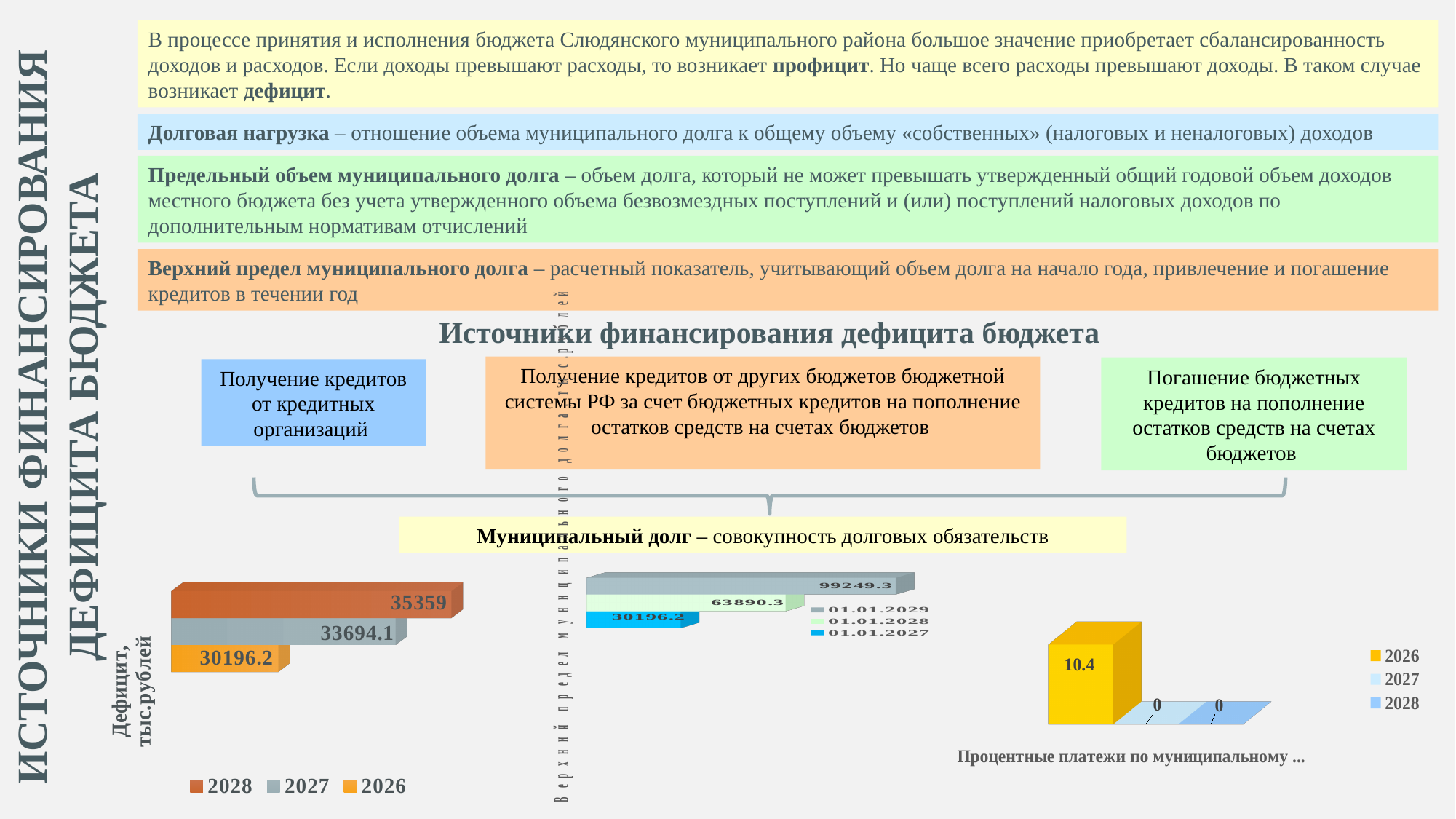
In the middle chart, what is the value for 01.01.2028? 63890.3 In the middle chart, what is the value for 01.01.2029? 99249.3 In the left chart (Дефицит, тыс.рублей), what is the value for 2028? 35359 What type of chart is the right chart (Процентные платежи по муниципальному ...)? Bar chart In the left chart (Дефицит, тыс.рублей), which year has the highest value? 2028 In the right chart (Процентные платежи по муниципальному ...), what is the value for 2026? 10.4 In the middle chart, which date has the lowest value? 01.01.2027 In the left chart (Дефицит, тыс.рублей), what is the value for 2026? 30196.2 In the left chart (Дефицит, тыс.рублей), what is the difference between the 2028 and 2027 values? 1664.9 In the middle chart, what is the difference between the 01.01.2029 and 01.01.2027 values? 69053.1 In the left chart (Дефицит, тыс.рублей), how many series does the legend list? 3 In the right chart (Процентные платежи по муниципальному ...), what is the value for 2028? 0